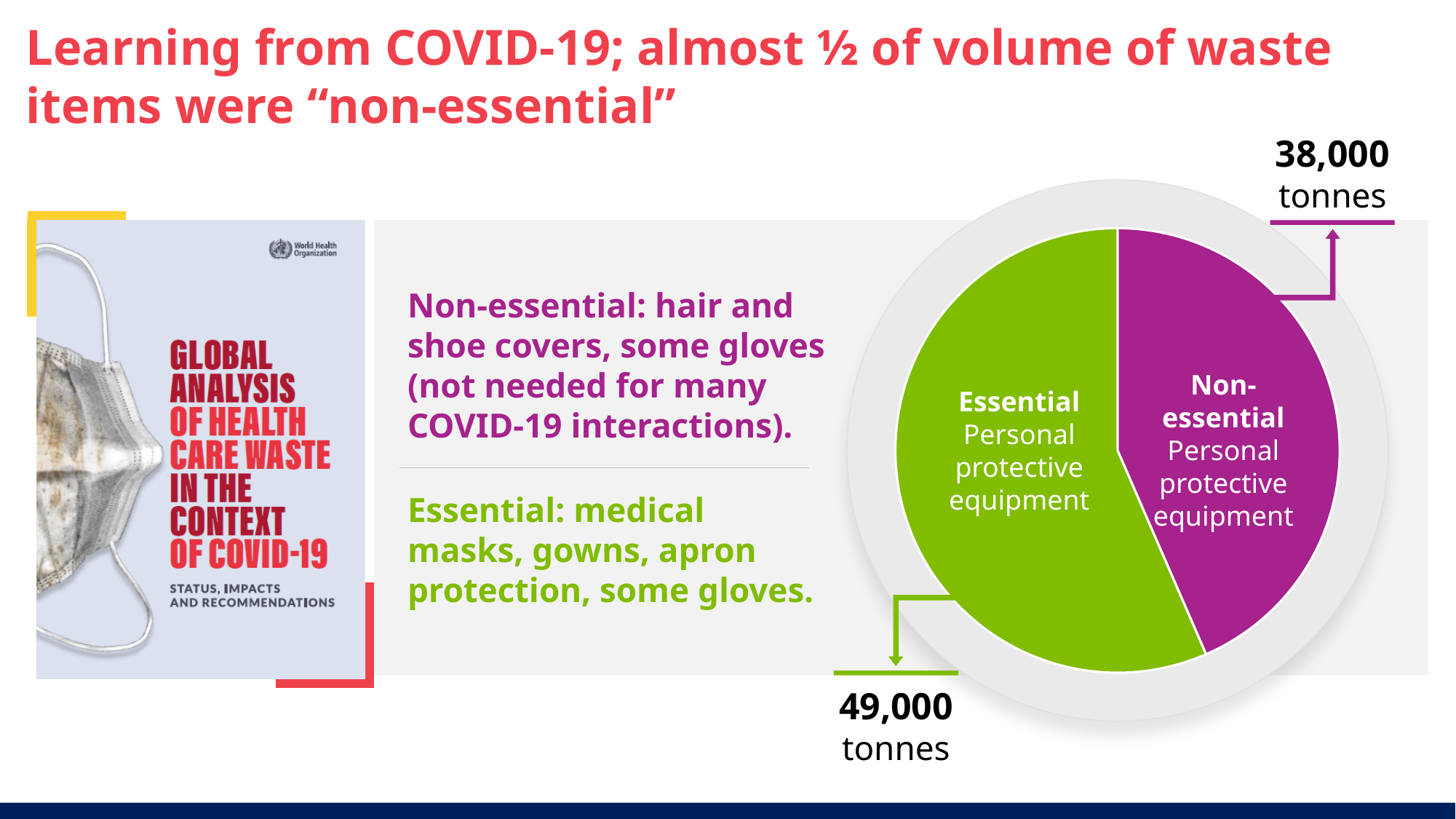
What is the difference in tonnes between Essential and Non-essential personal protective equipment? 11,000 tonnes Which slice of the pie chart is the smallest? Non-essential personal protective equipment What type of chart is shown on the slide? pie chart Which slice of the pie chart is the largest? Essential personal protective equipment Which is larger in the pie chart, Essential or Non-essential personal protective equipment? Essential What is the value for Non-essential personal protective equipment in the pie chart? 38,000 tonnes What is the value for Essential personal protective equipment in the pie chart? 49,000 tonnes What colour is the Non-essential personal protective equipment slice? purple What colour is the Essential personal protective equipment slice? green How many slices does the pie chart have? 2 What is the combined total of the two slices in the pie chart? 87,000 tonnes